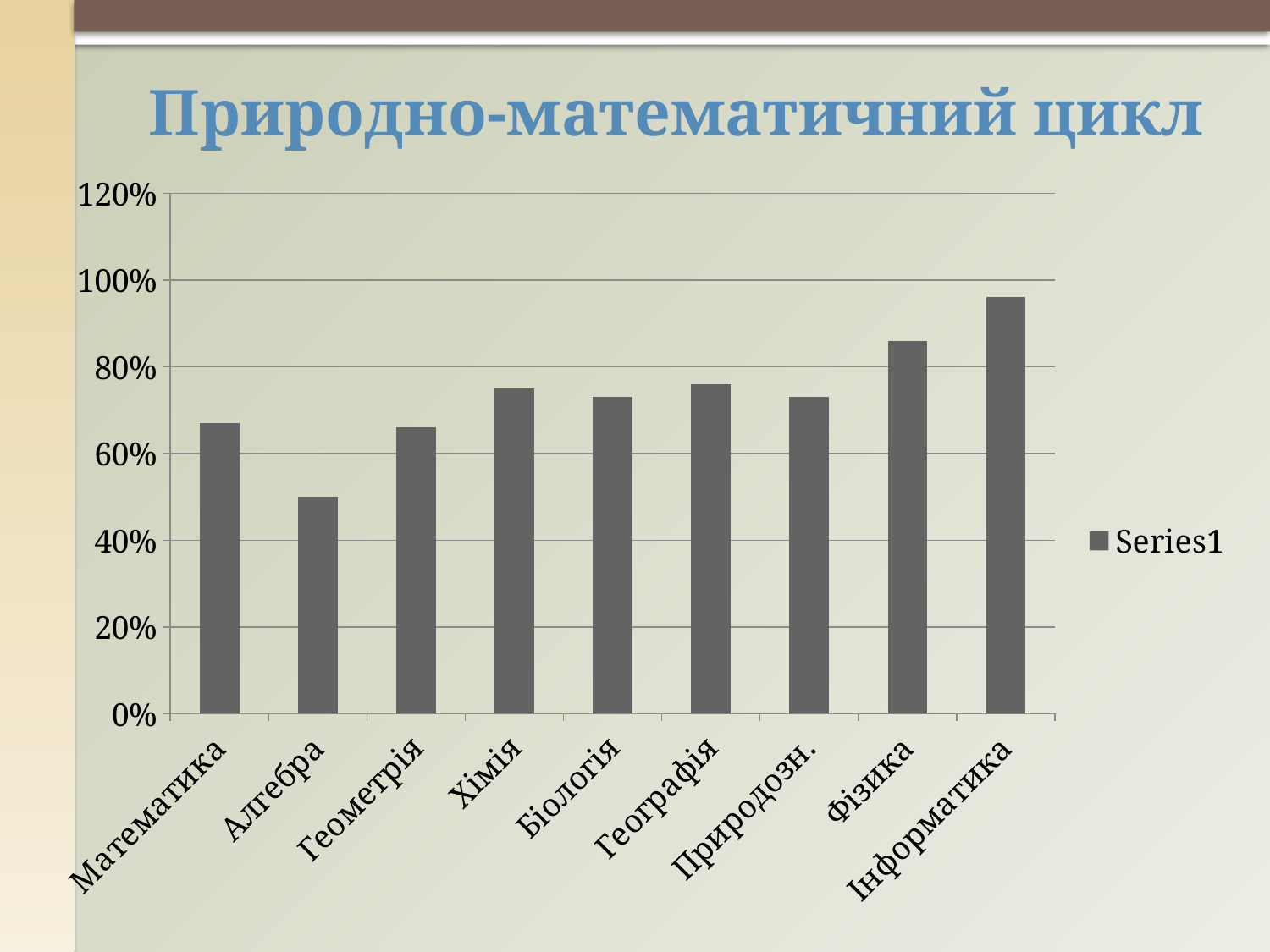
What is the name of the series shown in the legend? Series1 Which category has the highest value? Інформатика Which category has the lowest value? Алгебра How many series does the legend list? 1 Which is larger, the value for Математика or the value for Алгебра? Математика What is the title of the chart? Природно-математичний цикл Is the value for Інформатика greater or less than 80%? greater Is the value for Алгебра greater or less than 60%? less Is the value for Хімія greater or less than 80%? less What kind of chart is shown on the slide? bar chart Which is larger, the value for Фізика or the value for Хімія? Фізика How many categories are shown on the x axis of the chart? 9